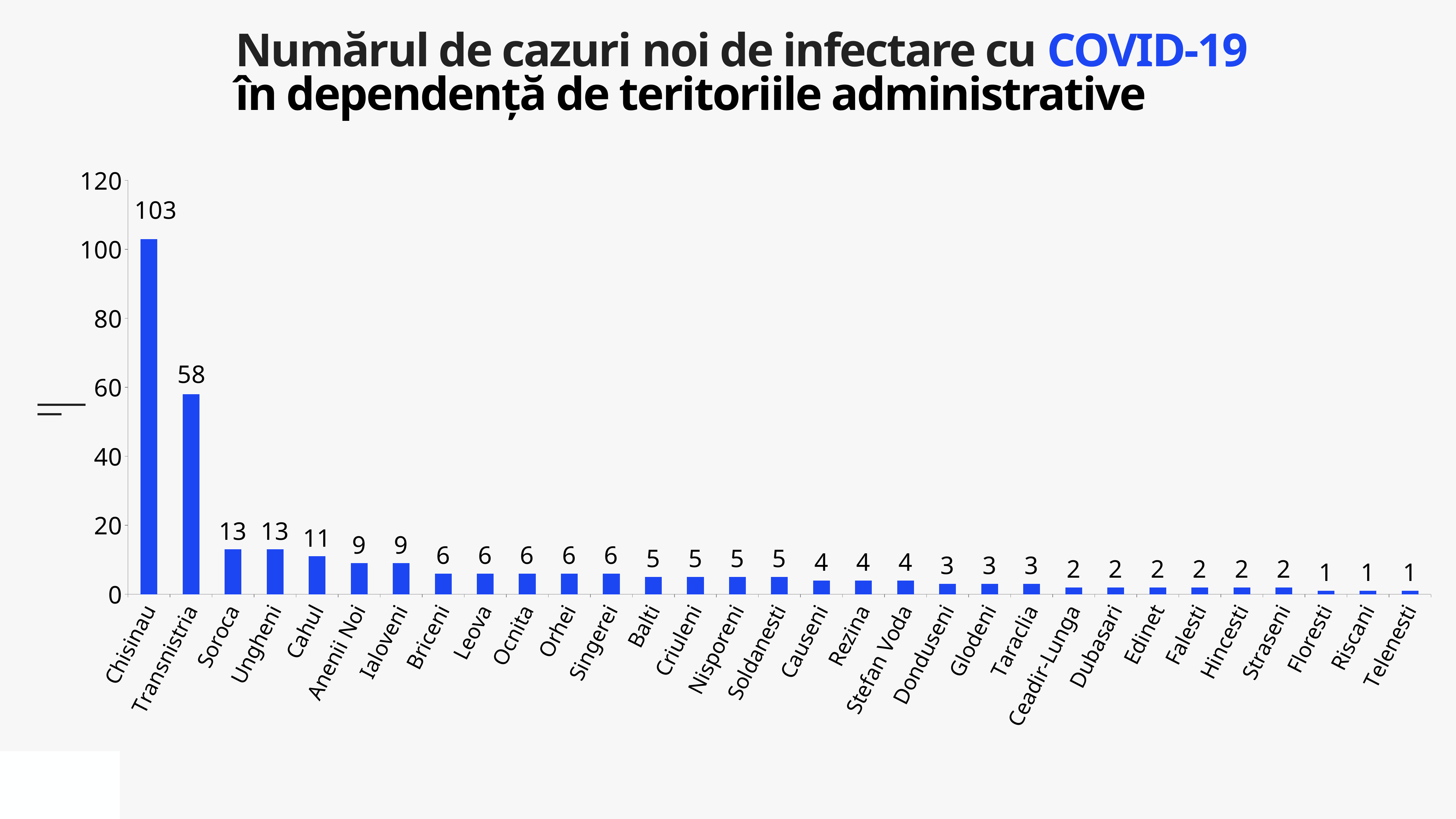
What is the value for Transnistria? 58 What kind of chart is shown on the slide? Bar chart What is the difference between the values for Chisinau and Transnistria? 45 How many territories are shown on the chart? 31 Which is larger, the value for Anenii Noi or the value for Balti? Anenii Noi What is the value for Stefan Voda? 4 What is the difference between the values for Soroca and Briceni? 7 What is the value for Cahul? 11 What is the value for Chisinau? 103 Do the values rise or fall from left to right along the x axis? Fall What is the lowest value shown on the chart? 1 Which territory has the highest number of new cases? Chisinau